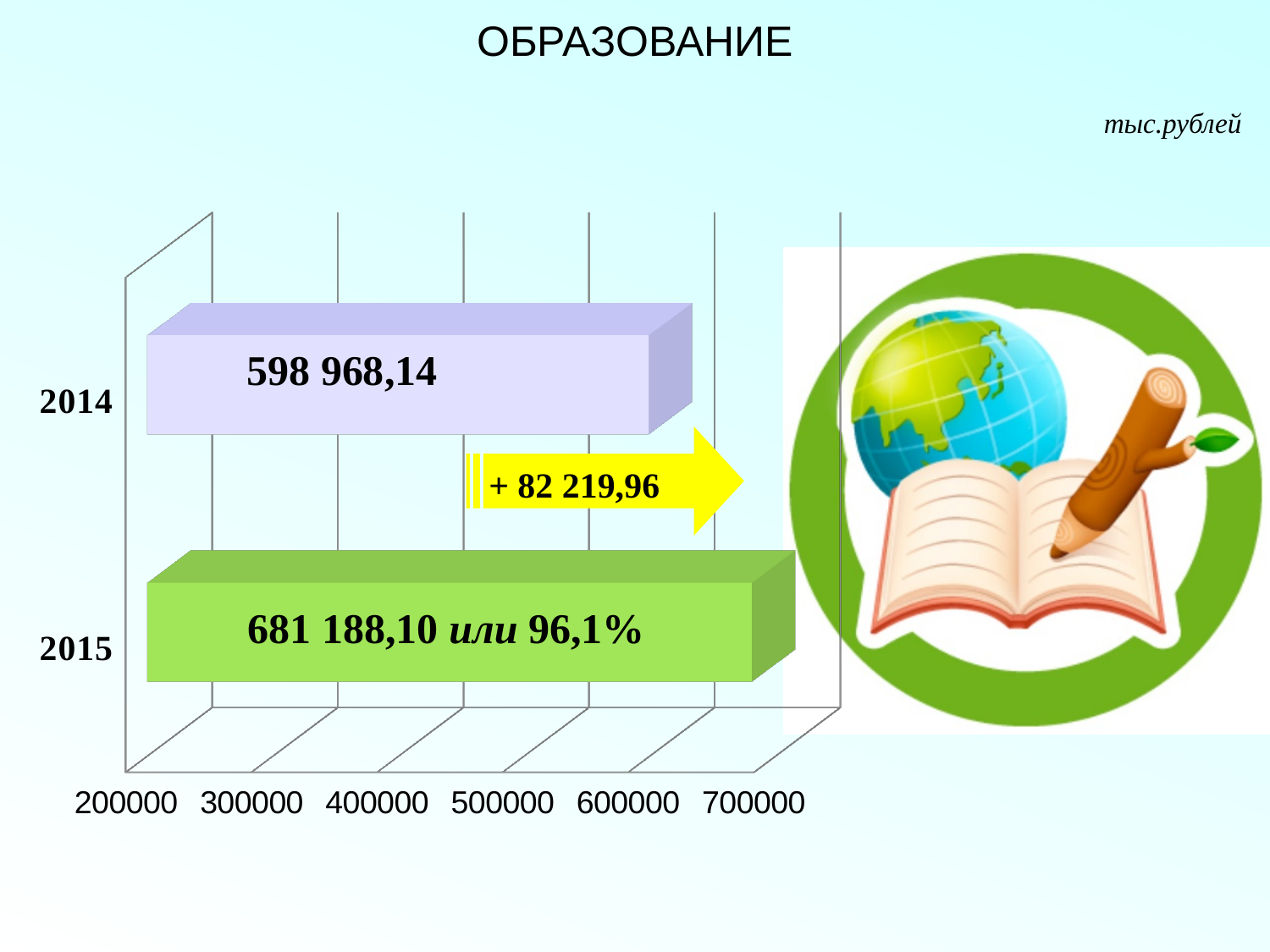
What unit of measurement is indicated on the slide? тыс.рублей Is the value for 2014 greater or less than 500000? greater Is the value for 2014 larger or smaller than the value for 2015? smaller What kind of chart is shown on the slide? bar chart What percentage is shown next to the 2015 value? 96,1% Is the value for 2015 greater or less than 700000? less How many years are shown in the chart? 2 By how much does the 2015 value exceed the 2014 value? 82 219,96 What is the value for 2015? 681 188,10 What is the value for 2014? 598 968,14 Which year has the lower value? 2014 Which year has the higher value? 2015